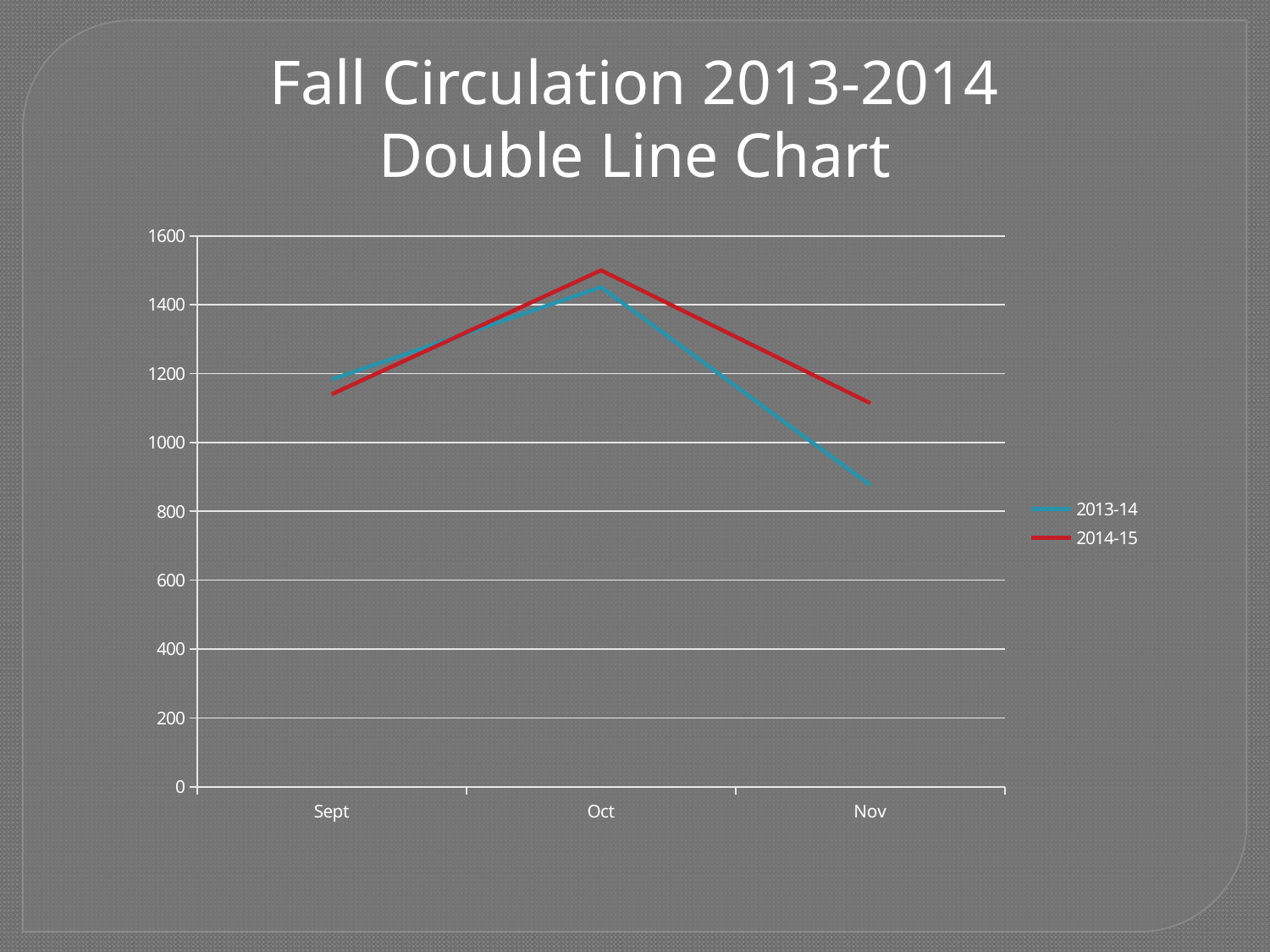
Do the values for the 2013-14 series rise or fall from Oct to Nov? fall Which series is drawn in red? 2014-15 In which month does the 2013-14 series reach its highest value? Oct Is the value for 2013-14 in Nov greater or less than 1000? less In which month is the 2014-15 series at its lowest value? Nov In which month does the 2014-15 series reach its highest value? Oct How many series does the legend list? 2 In Nov, which series has the larger value, 2013-14 or 2014-15? 2014-15 Is the value for 2014-15 in Oct greater or less than 1400? greater How many months are plotted along the x axis? 3 What kind of chart is shown on the slide? Line chart In which month is the 2013-14 series at its lowest value? Nov